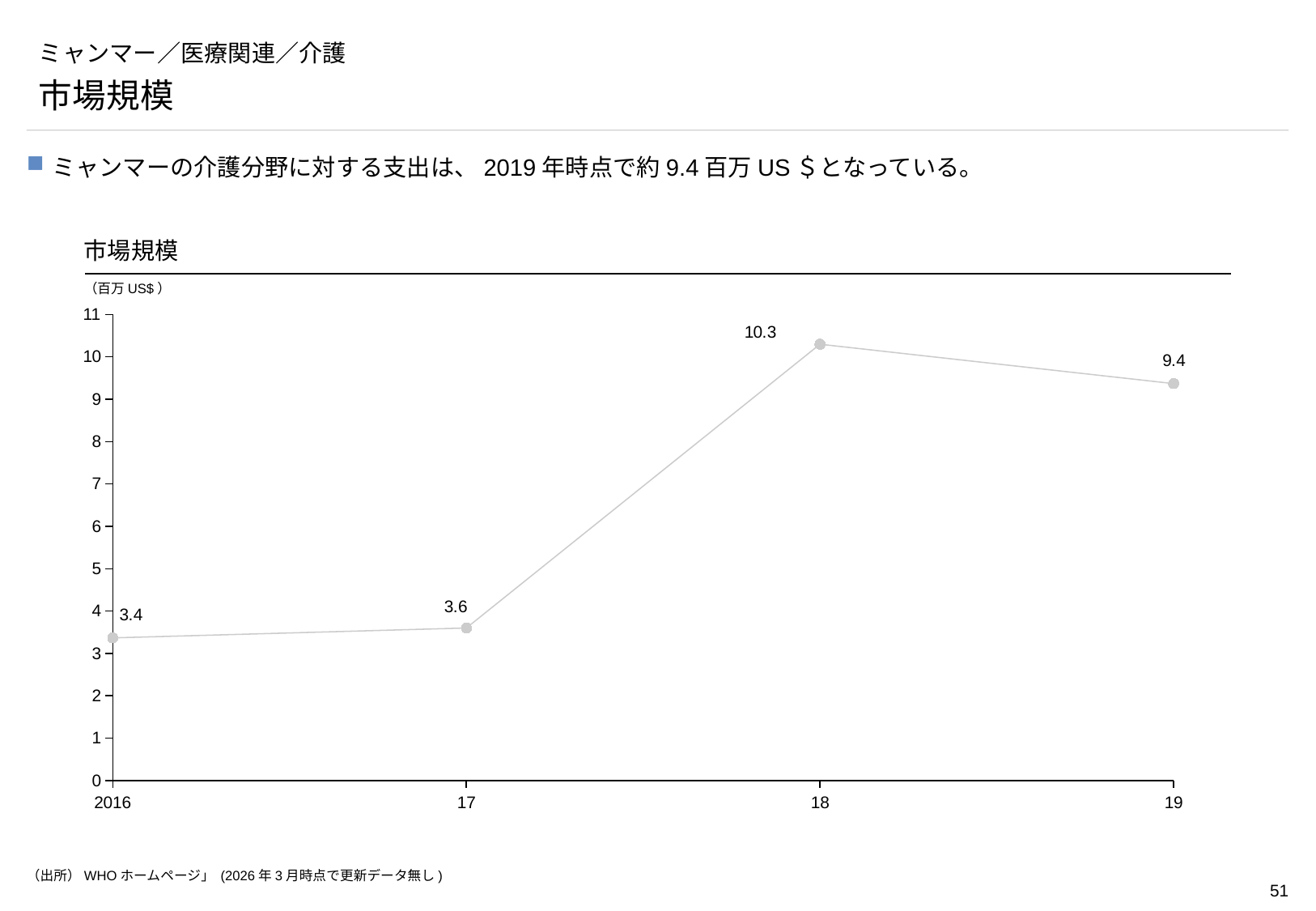
What kind of chart is shown on the slide? line chart What unit is shown for the chart's values? 百万 US$ What is the value for 18? 10.3 What is the difference between the values for 18 and 17? 6.7 What is the value for 2016? 3.4 Is the value for 18 greater or less than 10? greater How many data points are plotted on the chart? 4 What is the value for 17? 3.6 Which year has the lowest value? 2016 Which is larger, the value for 18 or the value for 19? 18 Which year has the highest value? 18 What is the value for 19? 9.4